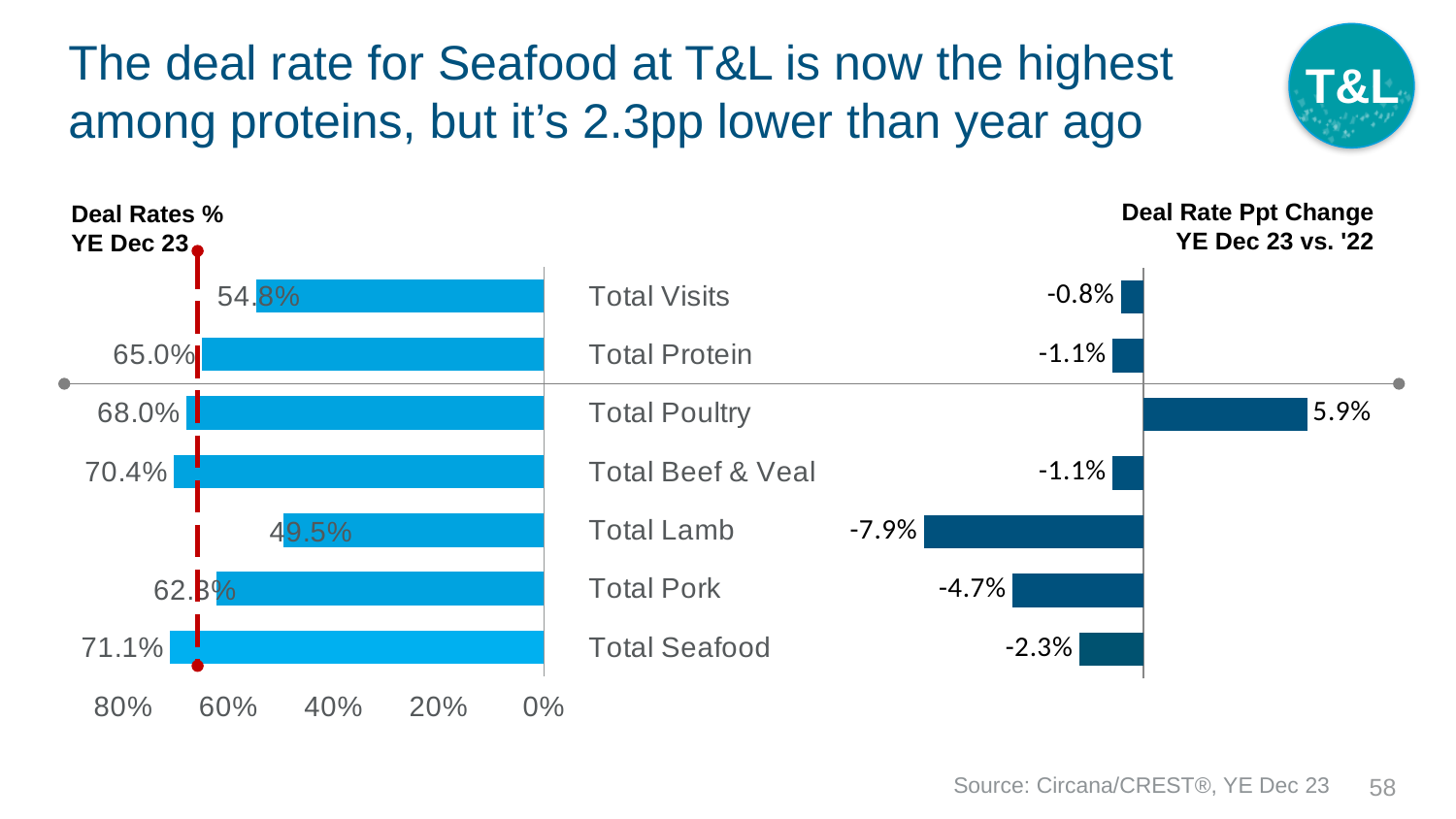
In the Deal Rates % YE Dec 23 chart, is the value for Total Visits greater or less than 60%? less In the Deal Rates % YE Dec 23 chart, what is the difference between Total Beef & Veal and Total Poultry? 2.4 percentage points In the Deal Rate Ppt Change YE Dec 23 vs. '22 chart, which is larger, the change for Total Pork or for Total Seafood? Total Seafood In the Deal Rates % YE Dec 23 chart, what is the value for Total Lamb? 49.5% What type of chart is the Deal Rate Ppt Change YE Dec 23 vs. '22 chart? Bar chart In the Deal Rates % YE Dec 23 chart, which category has the highest deal rate? Total Seafood How many categories are shown in the Deal Rates % YE Dec 23 chart? 7 In the Deal Rate Ppt Change YE Dec 23 vs. '22 chart, which category has the largest decline? Total Lamb In the Deal Rate Ppt Change YE Dec 23 vs. '22 chart, what is the value for Total Seafood? -2.3% In the Deal Rates % YE Dec 23 chart, what is the value for Total Seafood? 71.1% In the Deal Rates % YE Dec 23 chart, which category has the lowest deal rate? Total Lamb In the Deal Rate Ppt Change YE Dec 23 vs. '22 chart, what is the value for Total Poultry? 5.9%